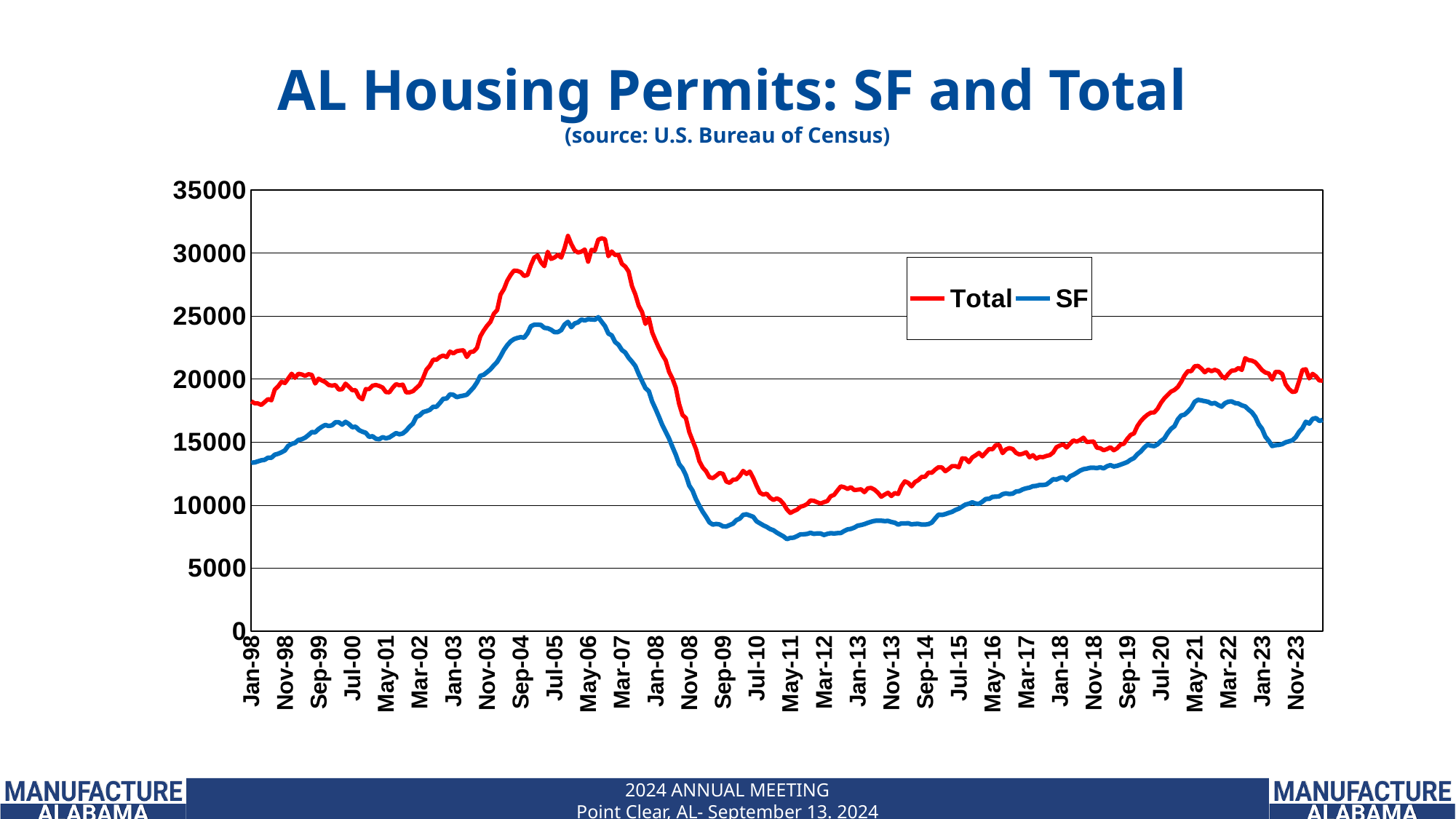
Is the value for SF at May-11 greater or less than 10000? less What kind of chart is shown on the slide? line chart How many series does the legend list? 2 What are the two series named in the legend? Total and SF Is the peak value of the Total series around 2006 greater or less than 30000? greater Is the value for Total at Jan-98 greater or less than 15000? greater Do the Total values rise or fall between May-06 and May-11? fall What colour is the line for the SF series? blue Which series has the higher values throughout the chart, Total or SF? Total Do the SF values rise or fall between May-11 and May-21? rise